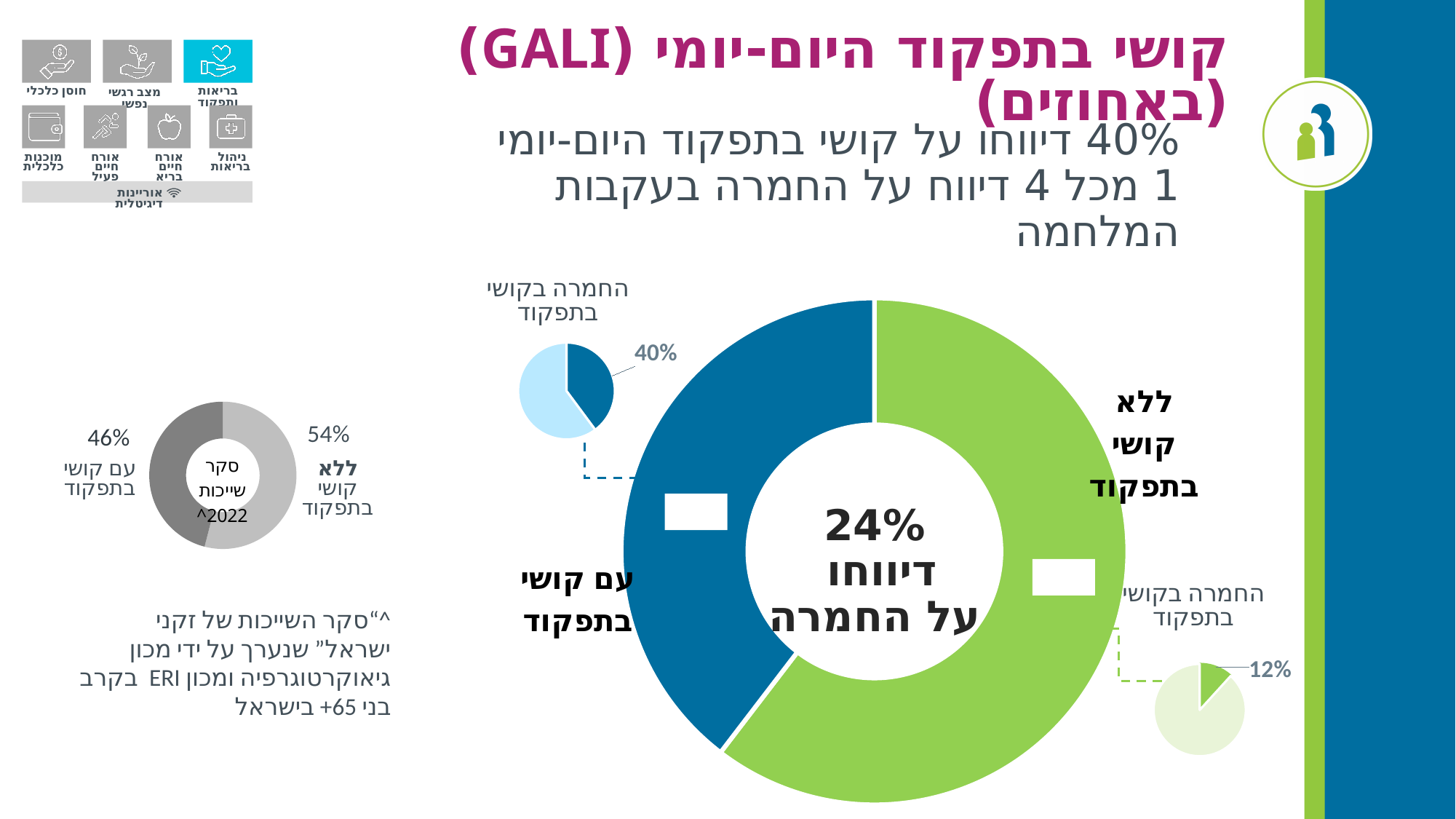
In the small green pie chart at the bottom right of the large donut (החמרה בקושי בתפקוד), what value is labelled? 12% In the small grey donut chart on the left (סקר שייכות 2022), what is the value for ללא קושי בתפקוד? 54% What kind of chart is the large green and blue chart in the centre of the slide? Donut (pie) chart In the small grey donut chart on the left (סקר שייכות 2022), which segment is larger, ללא קושי בתפקוד or עם קושי בתפקוד? ללא קושי בתפקוד In the small blue pie chart at the top left of the large donut (החמרה בקושי בתפקוד), what value is labelled? 40% In the large donut chart in the centre, which segment is larger, ללא קושי בתפקוד or עם קושי בתפקוד? ללא קושי בתפקוד In the large donut chart in the centre, how many segments are there? 2 In the small grey donut chart on the left (סקר שייכות 2022), how many segments are there? 2 Which of the two small pie charts beside the large donut shows the larger labelled value, the blue one at the top left or the green one at the bottom right? The blue one at the top left (40%) In the small grey donut chart on the left (סקר שייכות 2022), what is the value for עם קושי בתפקוד? 46% What text is written in the centre of the large donut chart? 24% דיווחו על החמרה In the small grey donut chart on the left (סקר שייכות 2022), what is the difference between the ללא קושי בתפקוד and עם קושי בתפקוד values? 8 percentage points